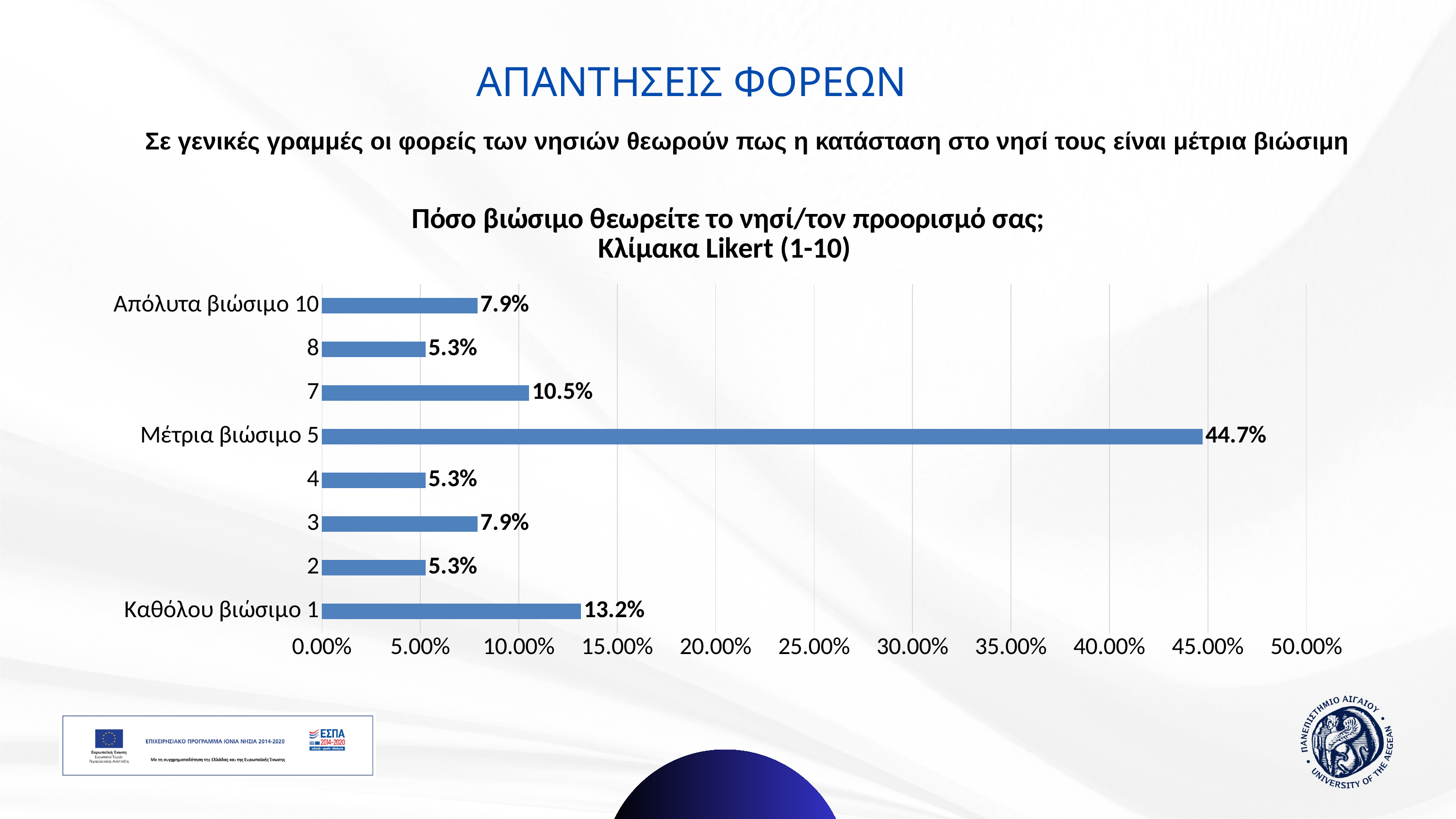
What is the value for "Καθόλου βιώσιμο 1"? 13.2% What is the difference between the values for "Μέτρια βιώσιμο 5" and "Καθόλου βιώσιμο 1"? 31.5% What is the title of the chart? Πόσο βιώσιμο θεωρείτε το νησί/τον προορισμό σας; Κλίμακα Likert (1-10) How many categories are shown in the chart? 8 What is the value for category 7? 10.5% What is the difference between the values for category 7 and category 4? 5.2% What type of chart is shown on the slide? bar chart What is the value for category 8? 5.3% What is the value for "Μέτρια βιώσιμο 5"? 44.7% Which category has the highest value? Μέτρια βιώσιμο 5 Which is larger, the value for "Καθόλου βιώσιμο 1" or the value for "Απόλυτα βιώσιμο 10"? Καθόλου βιώσιμο 1 What is the value for "Απόλυτα βιώσιμο 10"? 7.9%